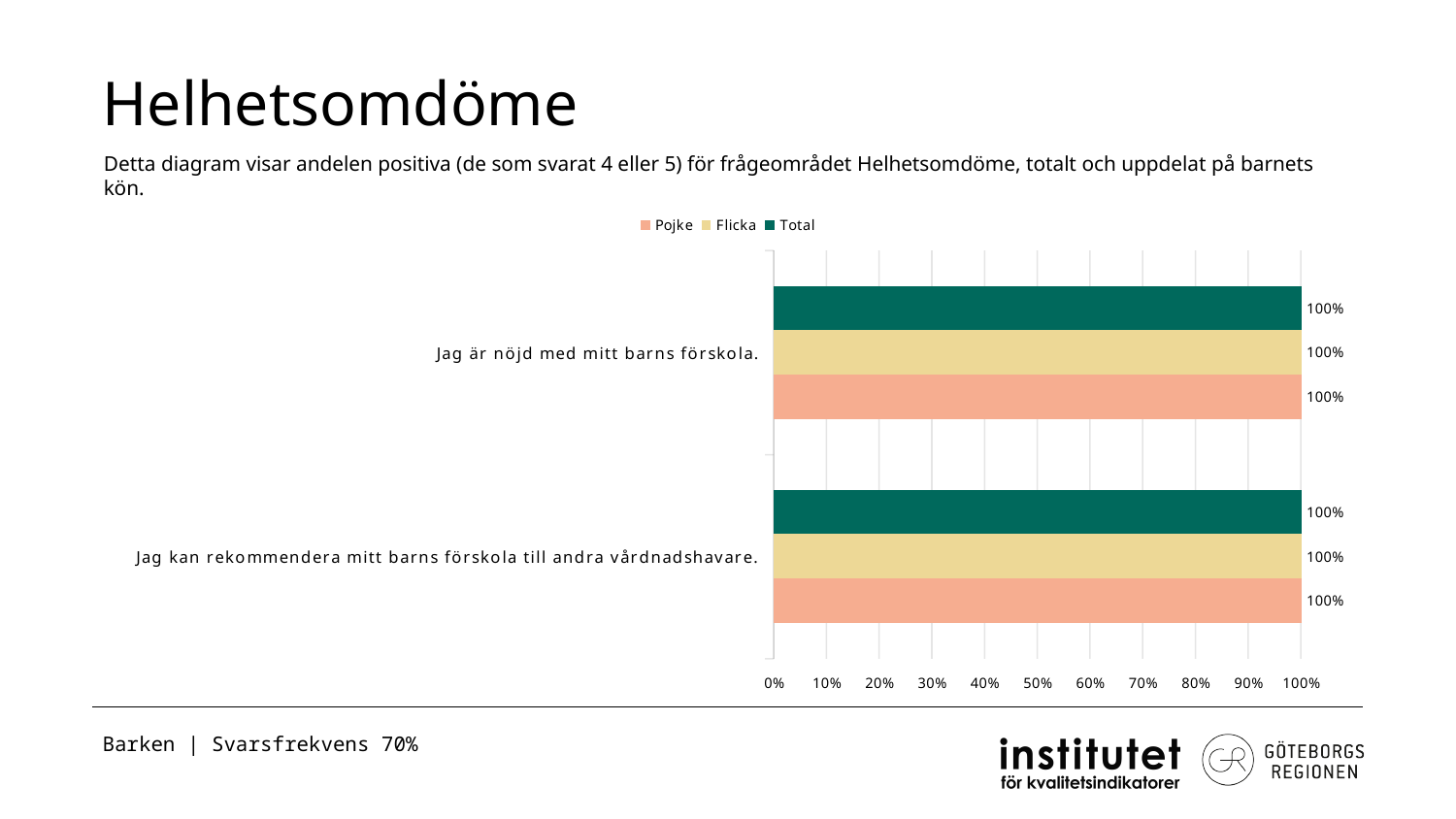
What is the value for Flicka for "Jag är nöjd med mitt barns förskola."? 100% What is the title of the slide containing the chart? Helhetsomdöme How many categories (statements) are plotted on the chart? 2 How many series does the legend list? 3 Is the value for Pojke for "Jag är nöjd med mitt barns förskola." greater or less than 90%? greater What is the difference between the Pojke and Flicka values for "Jag är nöjd med mitt barns förskola."? 0% What is the value for Pojke for "Jag kan rekommendera mitt barns förskola till andra vårdnadshavare."? 100% What is the value for Total for "Jag är nöjd med mitt barns förskola."? 100% Which series are listed in the legend? Pojke, Flicka, Total What is the value for Flicka for "Jag kan rekommendera mitt barns förskola till andra vårdnadshavare."? 100% What is the highest value shown on the x axis? 100% What kind of chart is shown on the slide? bar chart